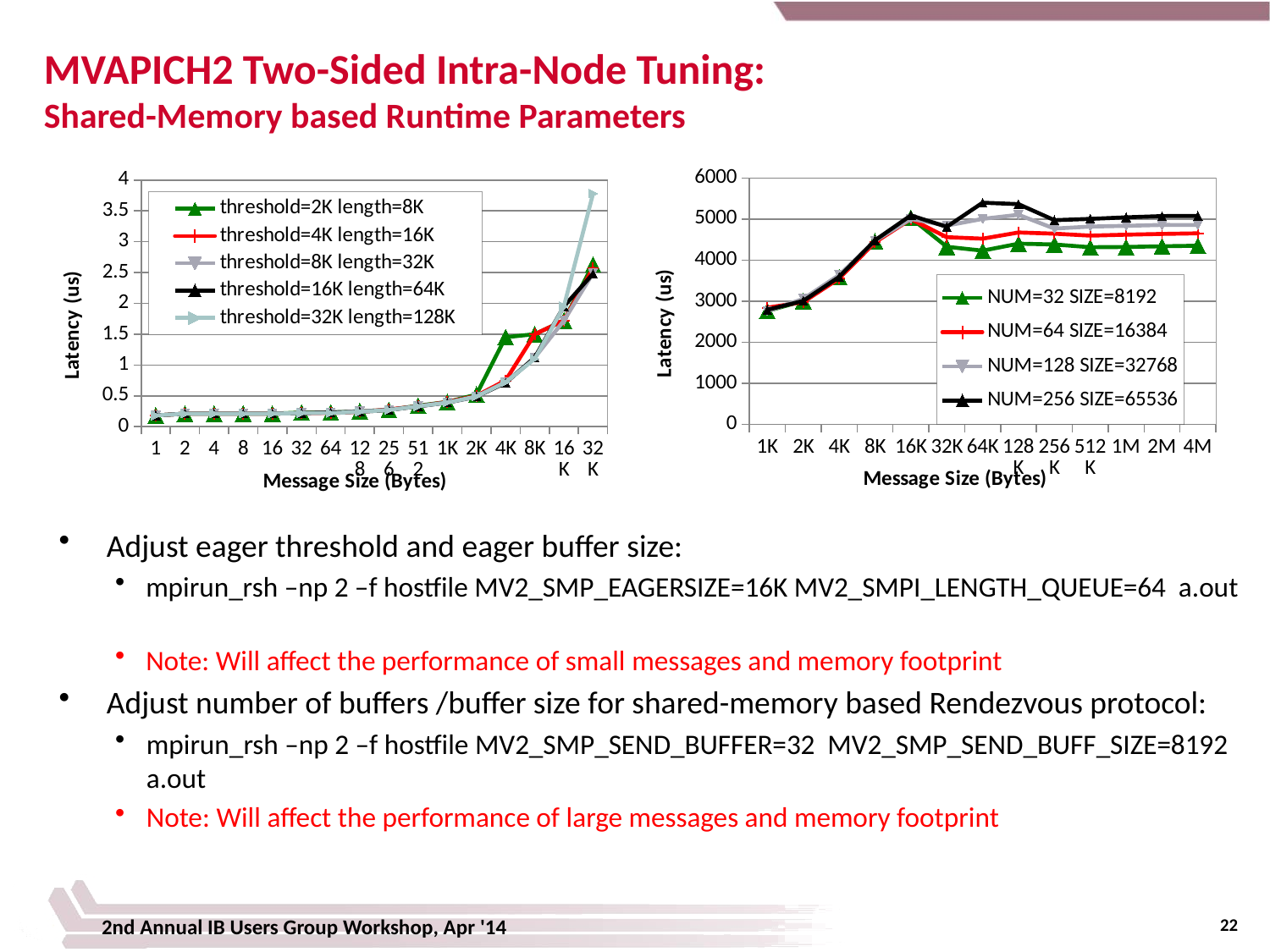
In the right chart, is the latency for NUM=256 SIZE=65536 at message size 64K greater or less than 5000? greater In the left chart, is the latency for threshold=32K length=128K at message size 32K greater or less than 3.5? greater In the left chart, at message size 32K, which has the larger latency: threshold=32K length=128K or threshold=2K length=8K? threshold=32K length=128K In the left chart, is the latency for threshold=2K length=8K at message size 4K greater or less than 1? greater In the right chart, which series has the highest latency at message size 64K? NUM=256 SIZE=65536 How many series does the legend of the left chart list? 5 How many series does the legend of the right chart list? 4 What kind of chart is the left chart (Latency vs Message Size, 1 to 32K)? line chart What is the y-axis title of the right chart? Latency (us) In the right chart, which series has the lowest latency at message size 64K? NUM=32 SIZE=8192 How many message-size categories are on the x axis of the right chart? 13